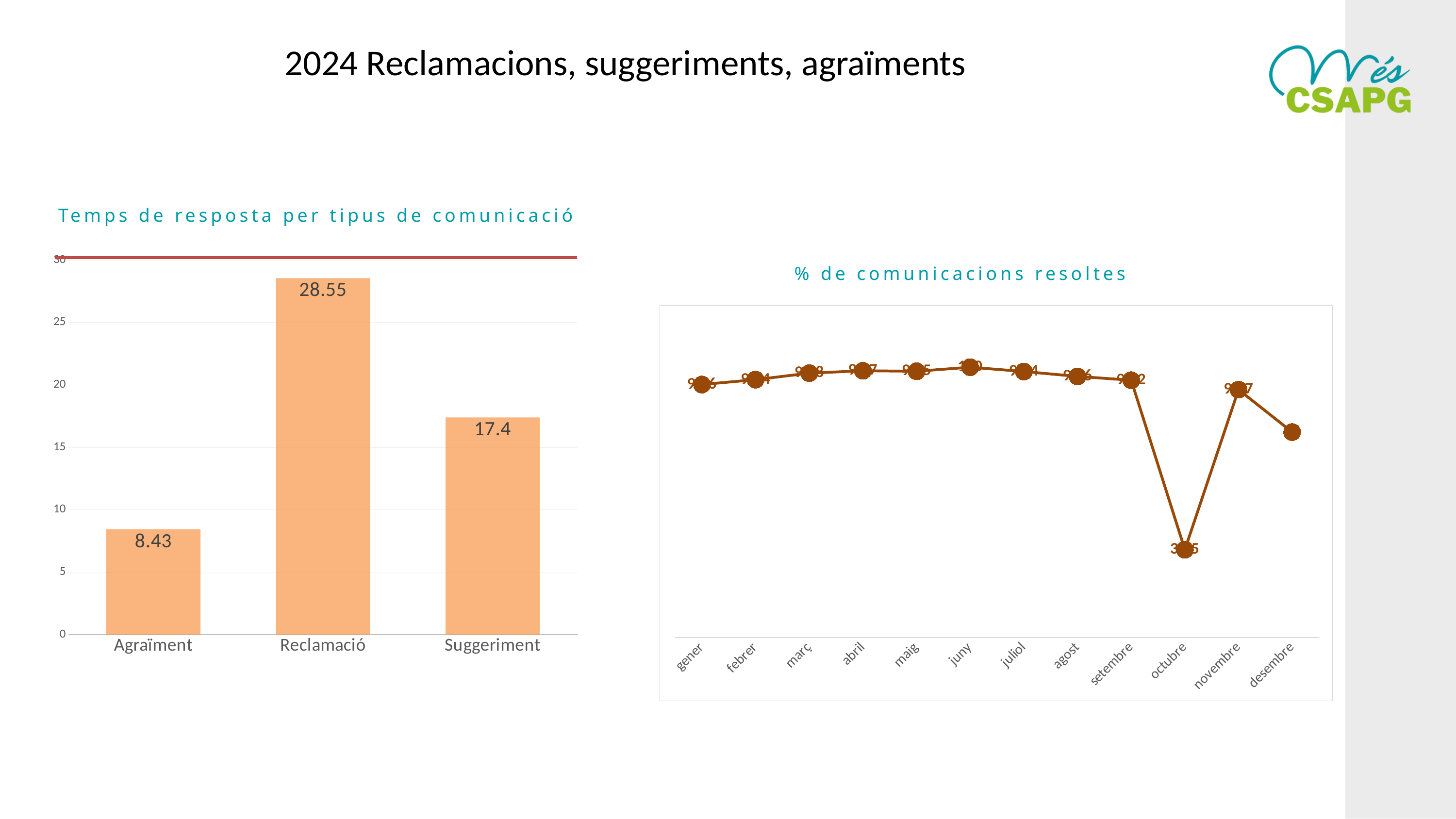
In the chart '% de comunicacions resoltes', how many months are plotted along the x axis? 12 In the chart 'Temps de resposta per tipus de comunicació', which category has the lowest value? Agraïment In the chart 'Temps de resposta per tipus de comunicació', what is the value for Suggeriment? 17.4 What kind of chart is '% de comunicacions resoltes'? line chart In the chart 'Temps de resposta per tipus de comunicació', what is the value for Agraïment? 8.43 What kind of chart is 'Temps de resposta per tipus de comunicació'? bar chart In the chart 'Temps de resposta per tipus de comunicació', which category has the highest value? Reclamació In the chart 'Temps de resposta per tipus de comunicació', what is the difference between the values for Reclamació and Suggeriment? 11.15 In the chart 'Temps de resposta per tipus de comunicació', how many categories are shown? 3 In the chart 'Temps de resposta per tipus de comunicació', what is the value for Reclamació? 28.55 In the chart 'Temps de resposta per tipus de comunicació', is the value for Reclamació greater or less than 25? greater In the chart '% de comunicacions resoltes', which month has the lowest value? octubre